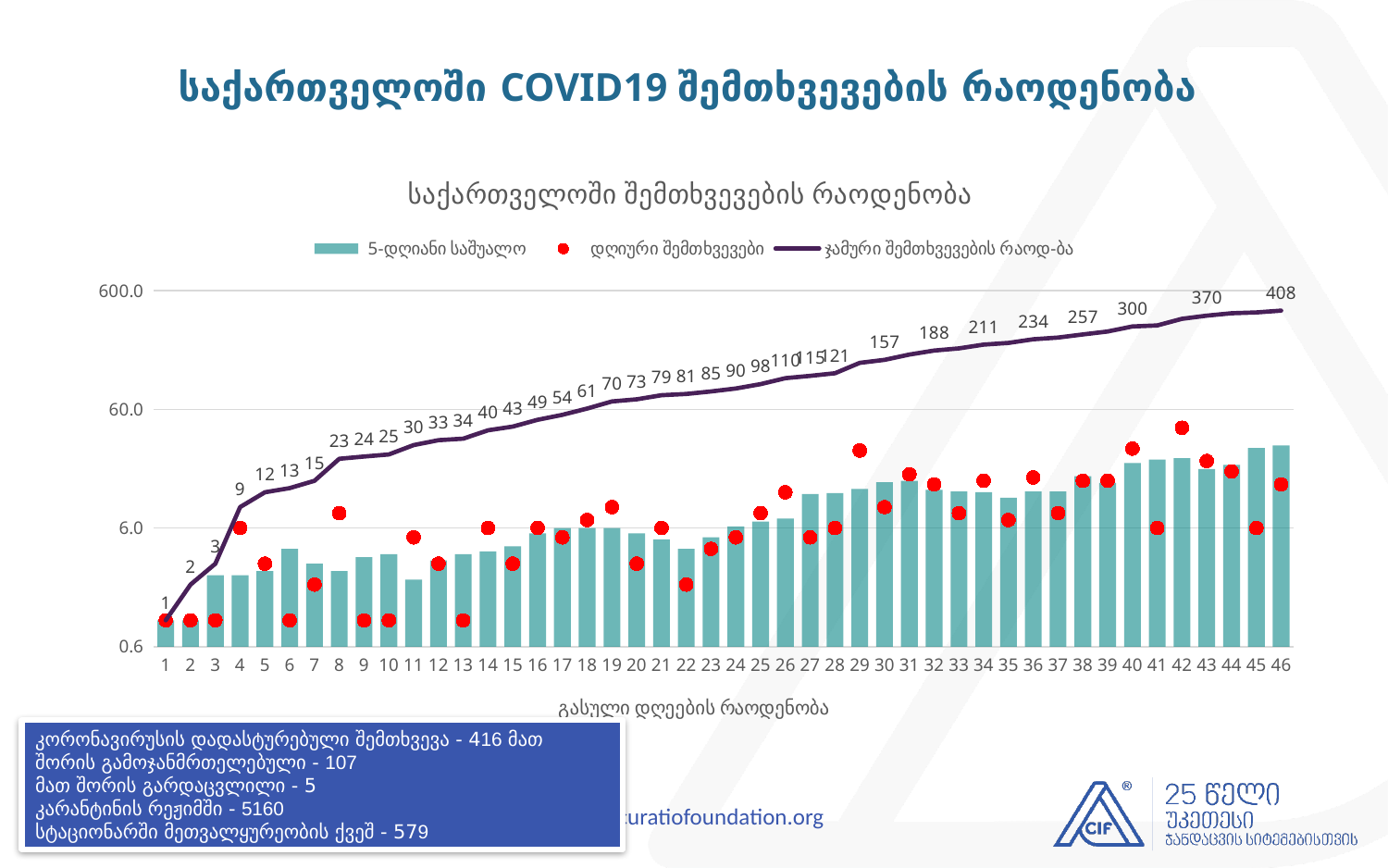
What is the last value labelled on the cumulative cases line (ჯამური შემთხვევების რაოდ-ბა), at day 46? 408 What kind of chart is this? A combination chart with bars, dots and a line Which labelled cumulative value is larger, 300 or 370? 370 How many days are shown along the x axis? 46 What is the highest value labelled on the cumulative cases line? 408 What is the first value labelled on the cumulative cases line, at day 1? 1 Is the 5-day average bar for day 46 greater or less than 6.0? greater How many series does the legend list? 3 What is the title of the chart? საქართველოში შემთხვევების რაოდენობა Does the cumulative cases line rise or fall from day 1 to day 46? Rises What is the cumulative cases value labelled at day 2? 2 What is the difference between the last two labelled cumulative values, 408 and 370? 38